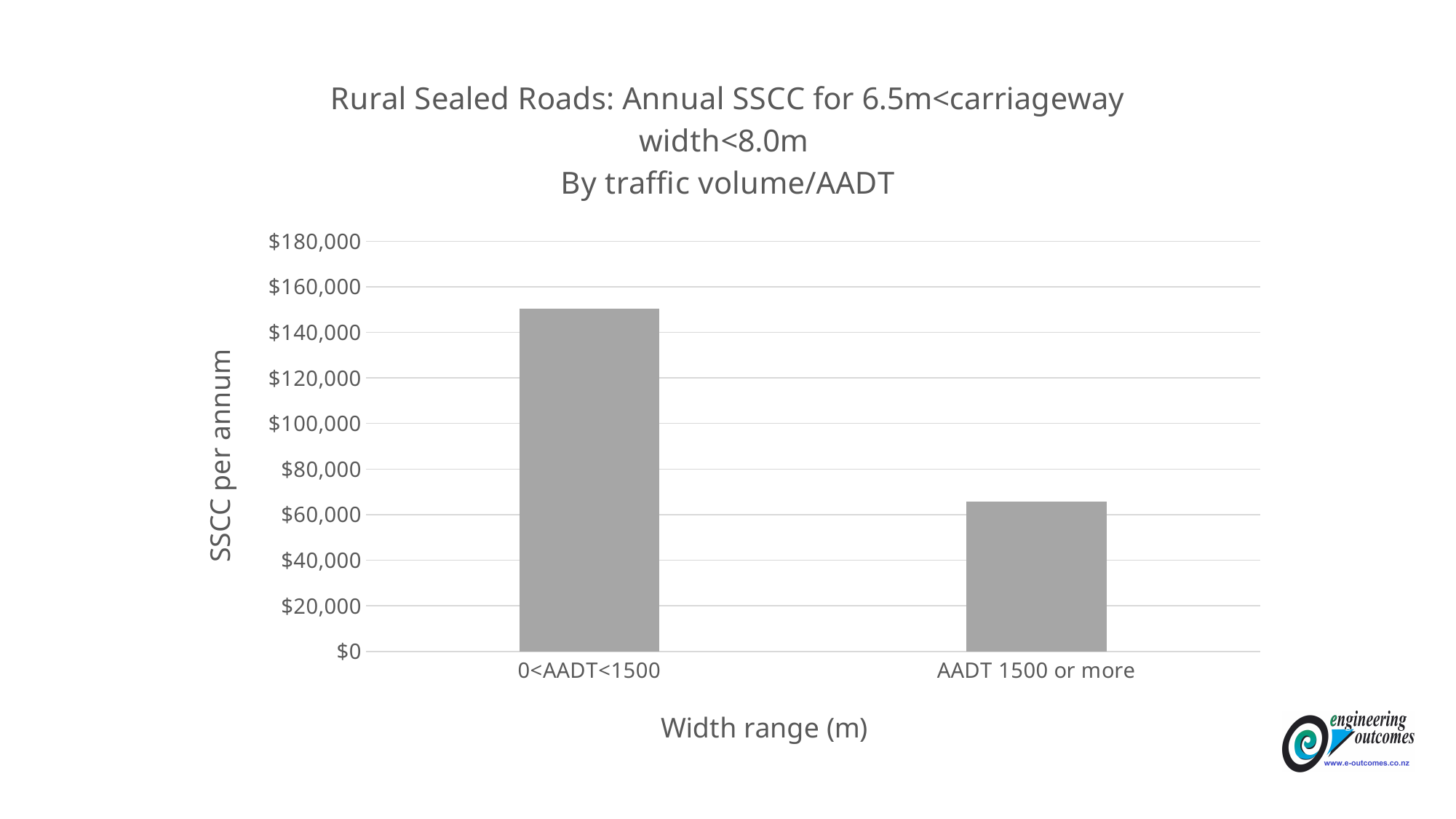
Do the values rise or fall from left to right along the x axis? fall Is the value for AADT 1500 or more greater or less than $60,000? greater Which category has the lowest SSCC per annum? AADT 1500 or more Which is larger, the value for 0<AADT<1500 or the value for AADT 1500 or more? 0<AADT<1500 What is the label of the y axis? SSCC per annum Is the value for 0<AADT<1500 greater or less than $160,000? less What kind of chart is shown on the slide? bar chart Is the value for 0<AADT<1500 greater or less than $140,000? greater What is the label of the x axis? Width range (m) Which category has the highest SSCC per annum? 0<AADT<1500 How many categories are shown on the x axis? 2